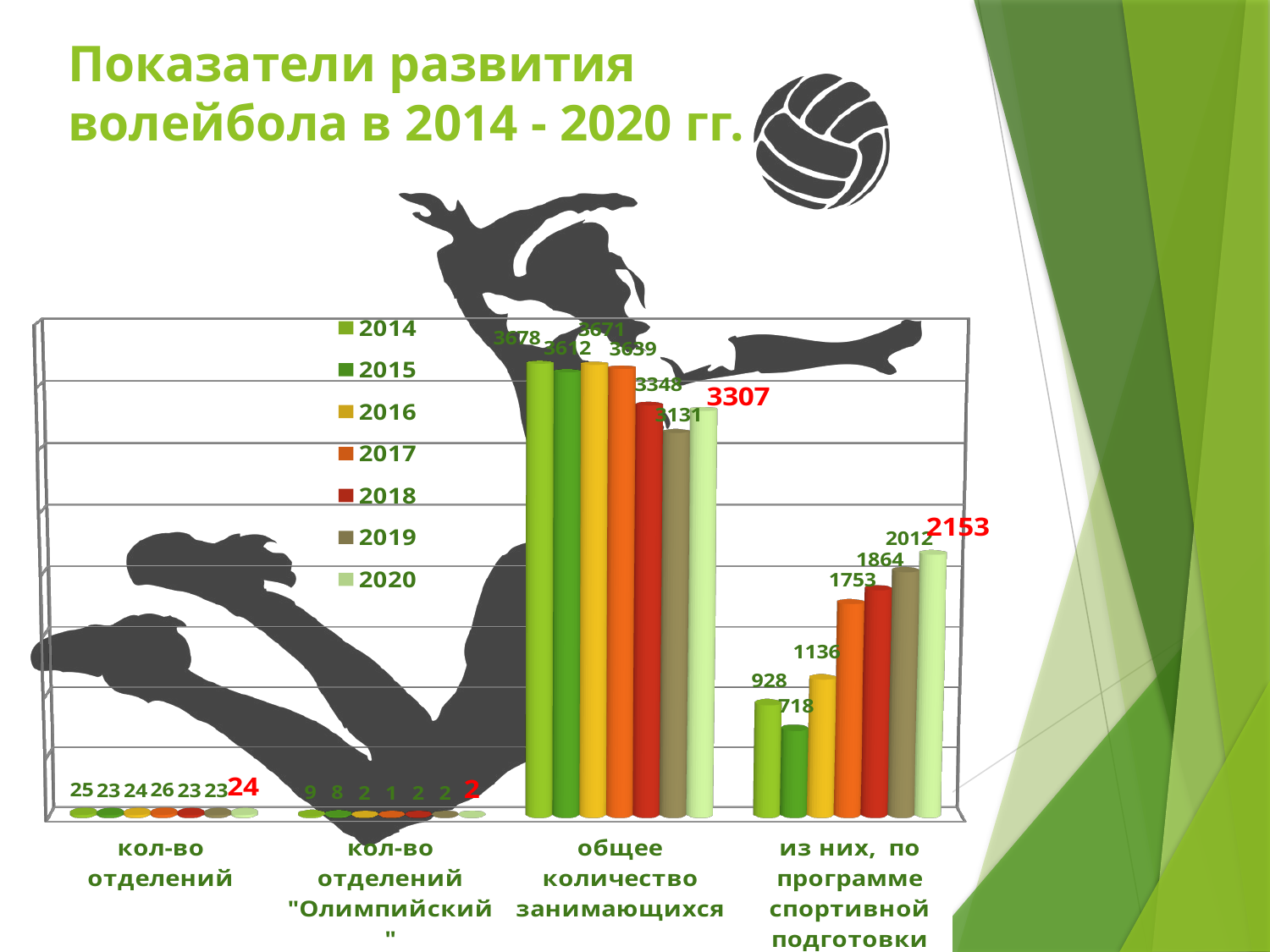
Which year has the highest value in the category "из них, по программе спортивной подготовки"? 2020 How many categories are shown on the x axis? 4 Do the values in the category "из них, по программе спортивной подготовки" rise or fall from 2016 to 2020? rise What is the title of the slide? Показатели развития волейбола в 2014 - 2020 гг. How many series does the legend list? 7 What kind of chart is shown on the slide? bar chart What is the value for 2020 in the category "общее количество занимающихся"? 3307 In the category "общее количество занимающихся", which is larger: the value for 2015 or the value for 2018? 2015 What is the value for 2014 in the category "из них, по программе спортивной подготовки"? 928 What is the value for 2017 in the category "кол-во отделений"? 26 Which year has the lowest value in the category "общее количество занимающихся"? 2019 What is the difference between the 2020 and 2019 values in the category "из них, по программе спортивной подготовки"? 141